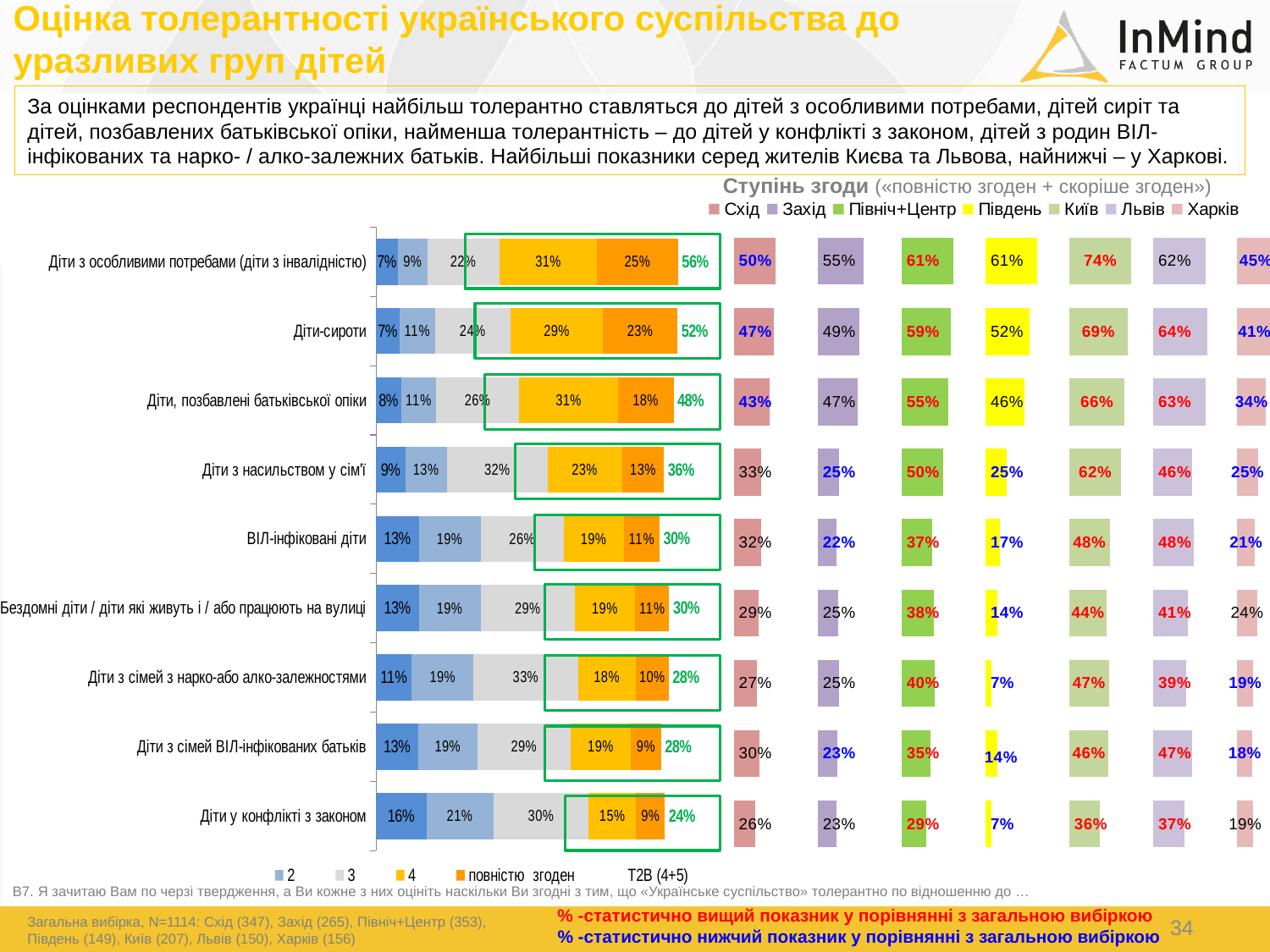
Which category has the lowest T2B (4+5) value in the stacked bar chart? Діти у конфлікті з законом What type of chart is used to show the agreement levels for each group of children? Stacked bar chart How many regions are listed in the legend of the «Ступінь згоди» table? 7 Which has a higher T2B (4+5) value: «Діти з насильством у сім'ї» or «ВІЛ-інфіковані діти»? Діти з насильством у сім'ї How many categories (groups of children) are shown in the stacked bar chart? 9 Which category has the highest T2B (4+5) value in the stacked bar chart? Діти з особливими потребами (діти з інвалідністю) What is the difference in T2B (4+5) between «Діти з особливими потребами» and «Діти у конфлікті з законом»? 32 percentage points In the regional table «Ступінь згоди», which region has the lowest value for «Діти у конфлікті з законом»? Південь What is the T2B (4+5) value for «Діти-сироти» in the stacked bar chart? 52% In the regional table «Ступінь згоди», what is the value for Київ for «Діти з особливими потребами»? 74% What is the value of segment «4» for «Діти, позбавлені батьківської опіки» in the stacked bar chart? 31% What share of respondents answered «повністю згоден» for «Діти з особливими потребами (діти з інвалідністю)»? 25%